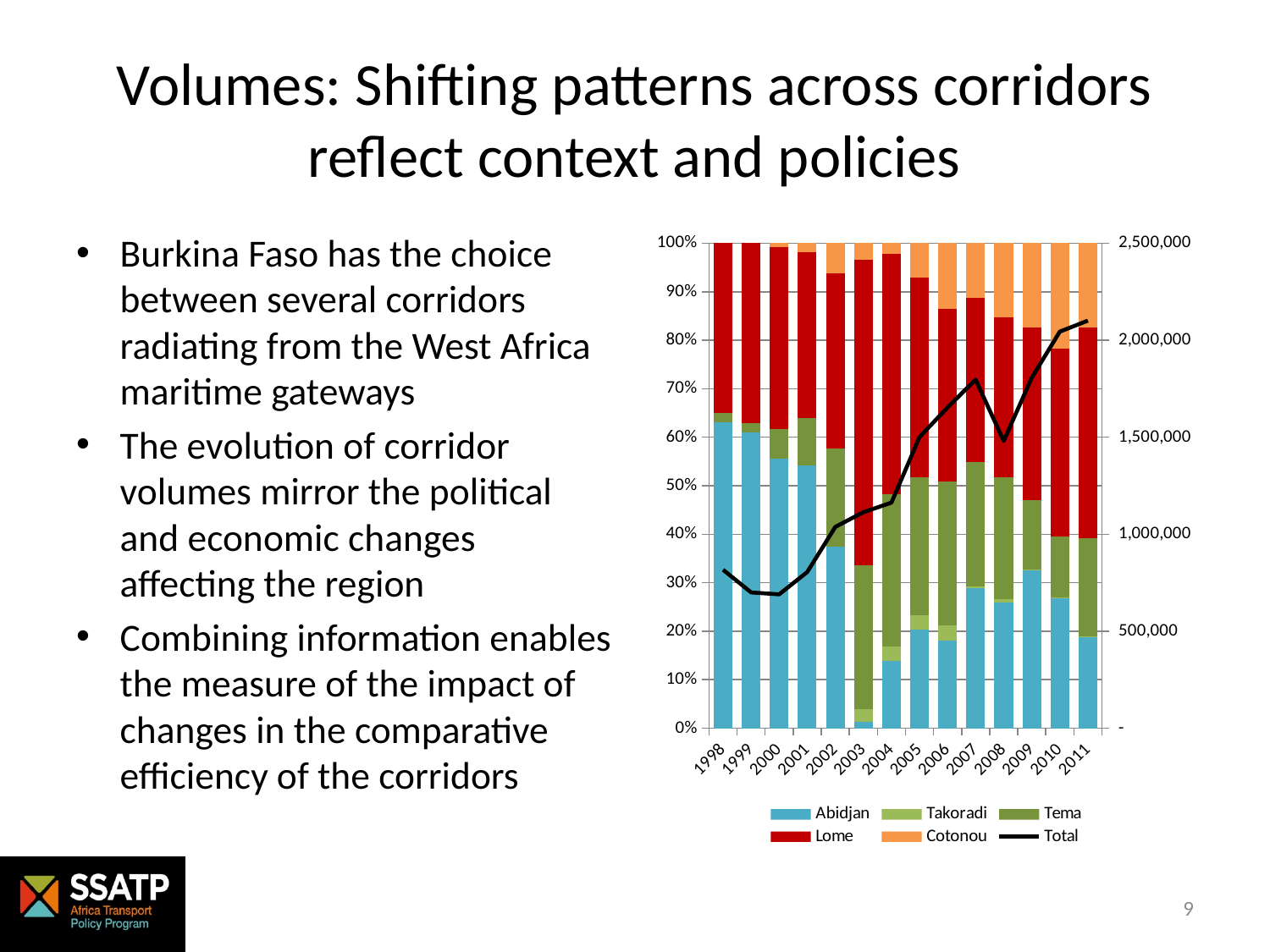
Is the Total line value for 2011 greater or less than 2,000,000? greater Is the Abidjan share of the bar for 1998 greater or less than 50%? greater In which year does the Total line reach its highest value? 2011 Is the Total line value for 1999 greater or less than 1,000,000? less How many series does the chart legend list? 6 How many years are shown along the x axis of the chart? 14 What kind of chart is shown on the slide? A stacked bar chart combined with a line Is the Abidjan share larger in 1998 or in 2011? 1998 In which year is the Abidjan share of the bar the smallest? 2003 Which series is drawn as a line rather than as bars? Total